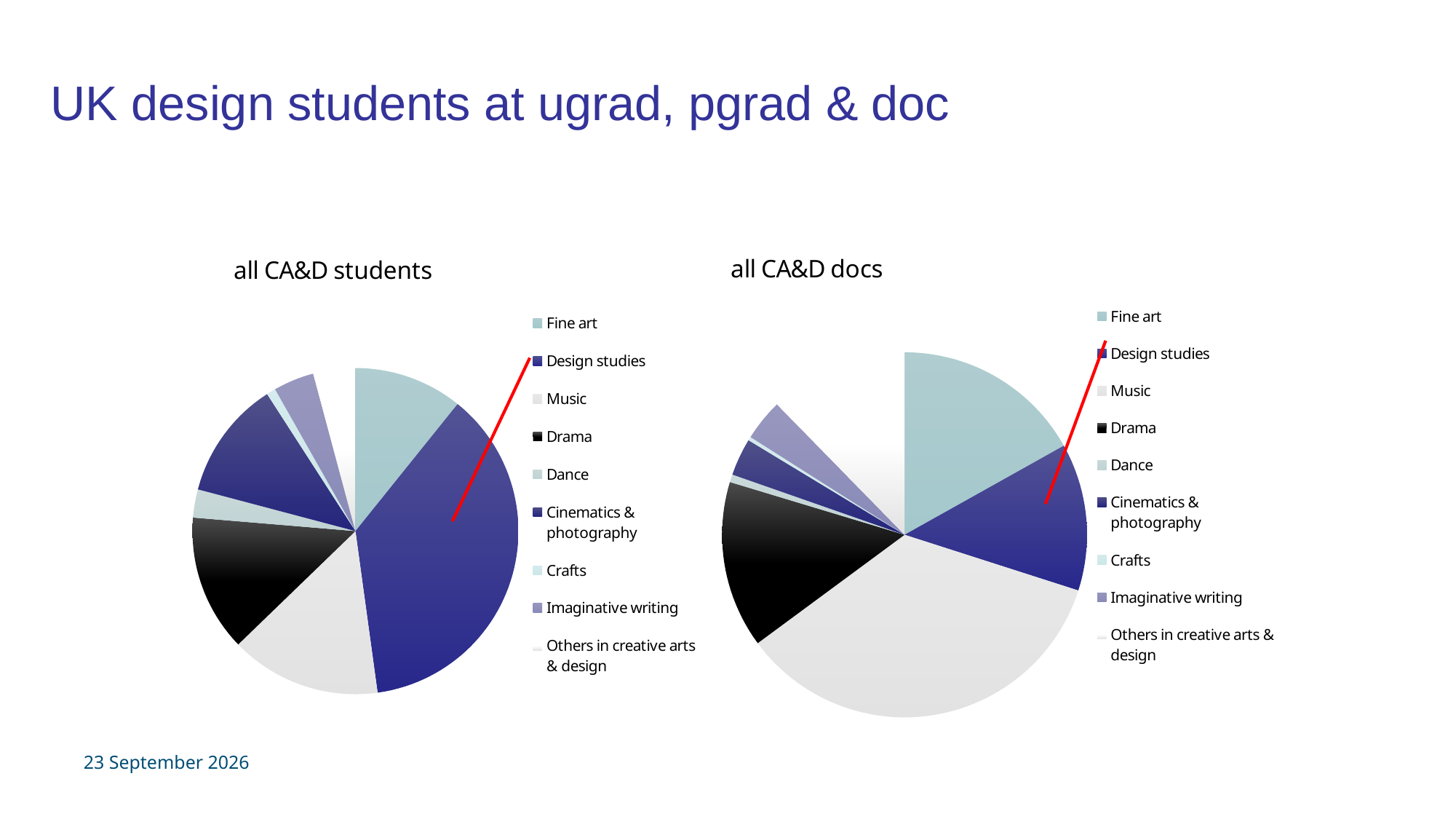
How many categories does the legend of the "all CA&D docs" chart list? 9 In the "all CA&D docs" chart, which category has the smallest slice? Crafts What is the title of the pie chart on the right of the slide? all CA&D docs How many categories does the legend of the "all CA&D students" chart list? 9 In the "all CA&D students" chart, which category has the largest slice? Design studies In the "all CA&D students" chart, which slice is larger: Design studies or Music? Design studies In the "all CA&D docs" chart, which slice is larger: Fine art or Design studies? Fine art What kind of chart is the "all CA&D docs" chart? pie chart In the "all CA&D docs" chart, which category has the largest slice? Music In the "all CA&D students" chart, which slice is larger: Drama or Dance? Drama What kind of chart is the "all CA&D students" chart? pie chart In the "all CA&D students" chart, which category has the smallest slice? Crafts